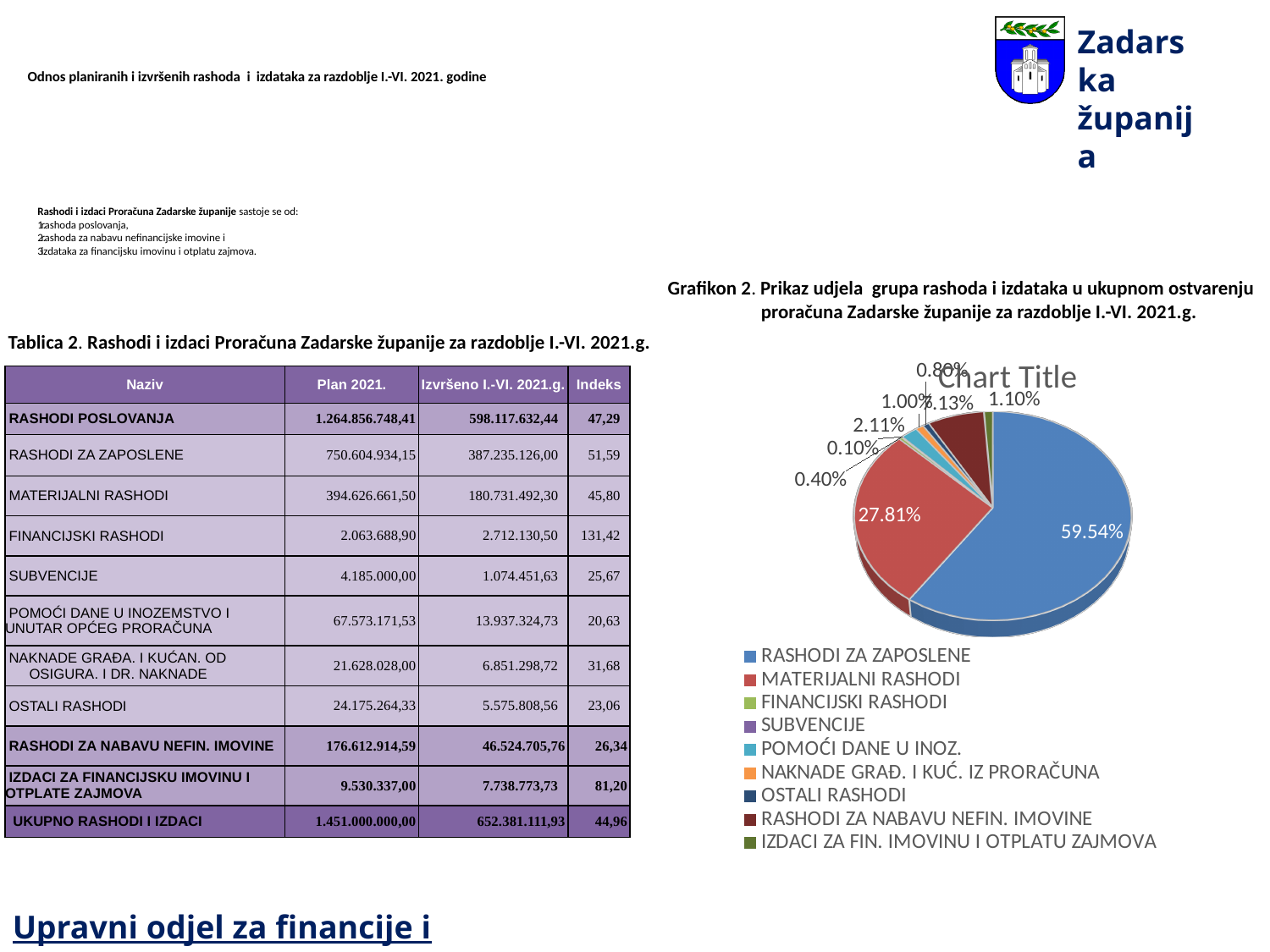
What is the smallest percentage label shown on the pie chart? 0.10% What share of the pie chart does RASHODI ZA NABAVU NEFIN. IMOVINE account for? 7.13% How many categories does the pie chart's legend list? 9 By how many percentage points does the RASHODI ZA ZAPOSLENE slice exceed the MATERIJALNI RASHODI slice? 31.73 What colour is the RASHODI ZA ZAPOSLENE slice in the pie chart? blue What share of the pie chart does RASHODI ZA ZAPOSLENE account for? 59.54% What share of the pie chart does MATERIJALNI RASHODI account for? 27.81% Which category has the largest slice in the pie chart? RASHODI ZA ZAPOSLENE What is the title displayed above the pie chart? Chart Title Is the share for RASHODI ZA ZAPOSLENE greater or less than 50%? greater Which slice is larger in the pie chart: RASHODI ZA ZAPOSLENE or MATERIJALNI RASHODI? RASHODI ZA ZAPOSLENE What type of chart is shown on the slide? pie chart